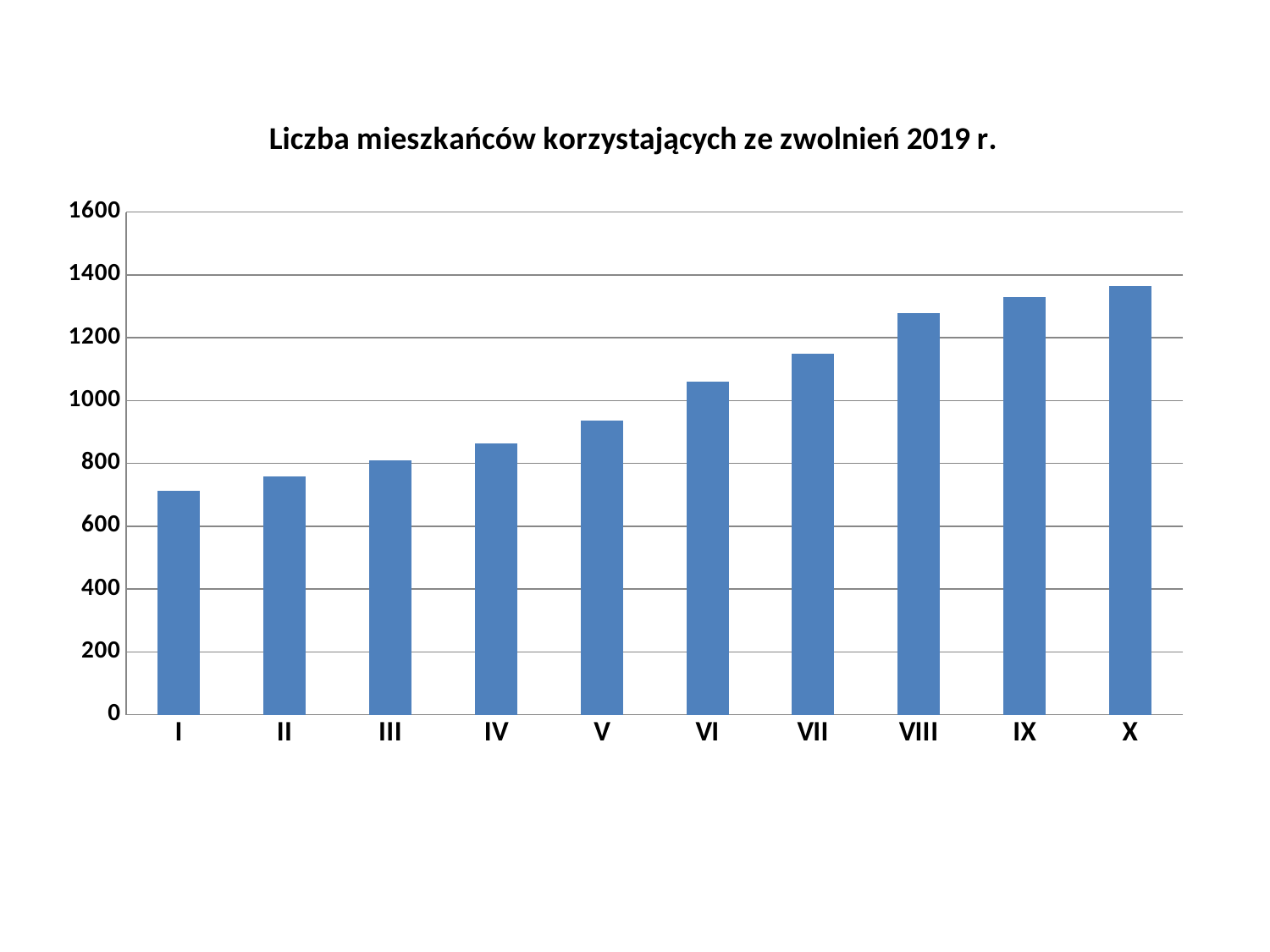
Is the value for V greater or less than 1000? less Which category has the lowest value? I Do the values rise or fall from I to X along the x axis? rise Is the value for X greater or less than 1400? less How many categories are shown on the x axis? 10 Which is larger, the value for IV or the value for VII? VII Is the value for VI greater or less than 1000? greater Which category has the highest value? X What is the title of the chart? Liczba mieszkańców korzystających ze zwolnień 2019 r. What kind of chart is shown on the slide? bar chart